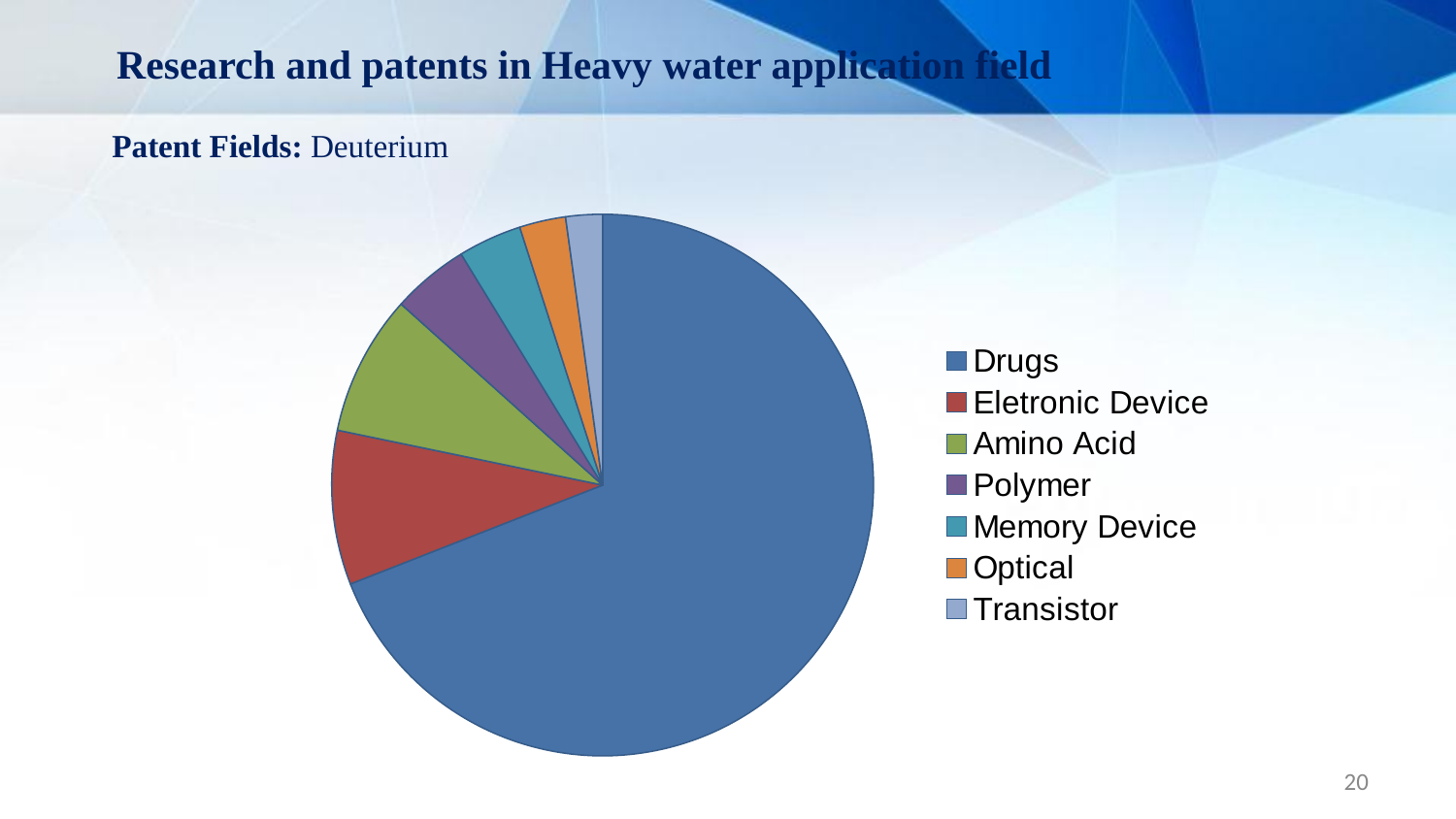
Which slice is larger, Drugs or Memory Device? Drugs Which slice is larger, Amino Acid or Polymer? Amino Acid What kind of chart is shown on the slide? pie chart Is the Drugs slice larger than all the other slices combined? yes Which category has the largest slice of the pie chart? Drugs How many entries does the legend of the pie chart list? 7 Which category has the second-largest slice of the pie chart? Eletronic Device How many categories does the pie chart show? 7 What colour is the Drugs slice in the pie chart? blue Which category is listed last in the legend of the pie chart? Transistor